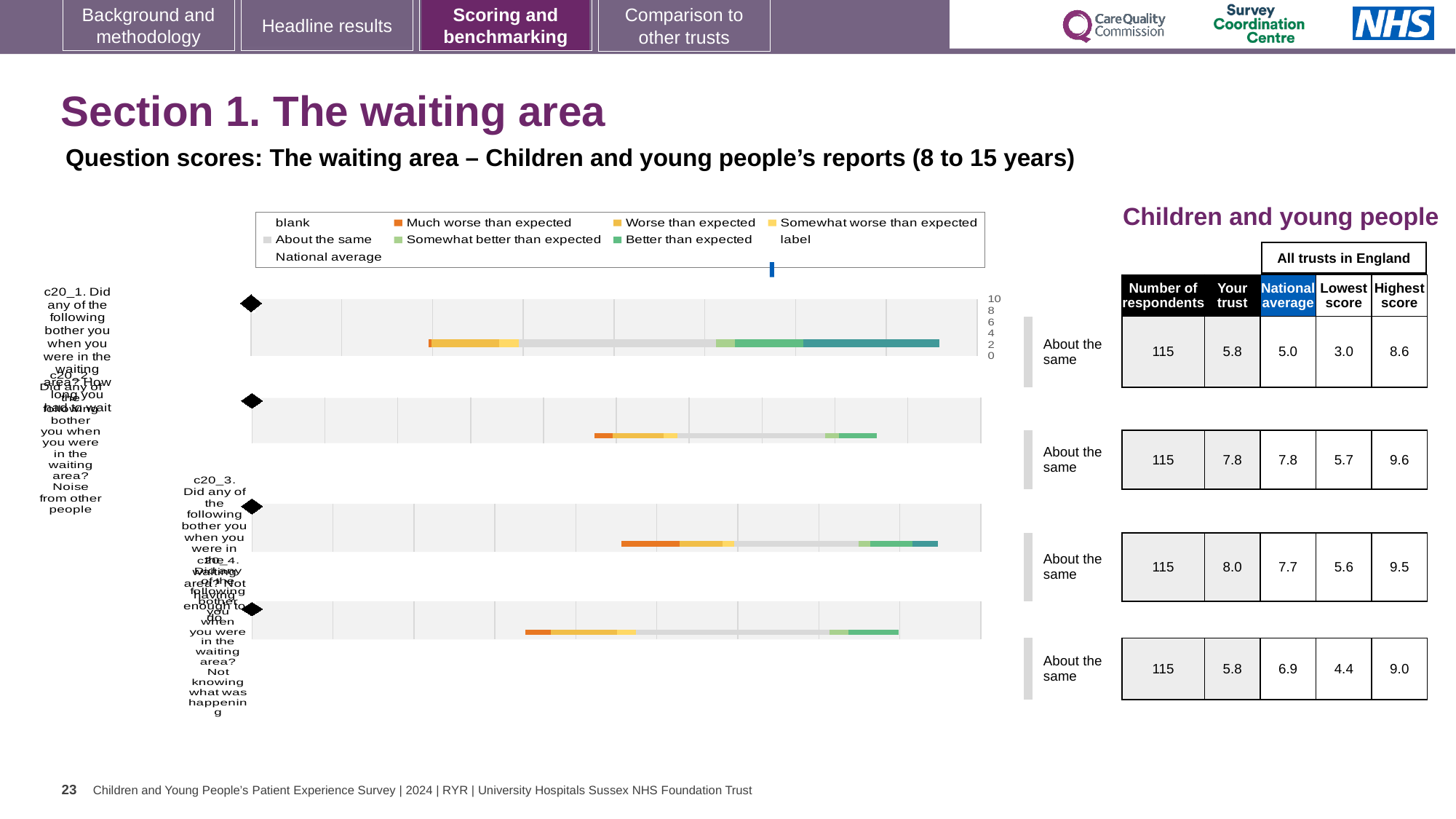
What benchmark category is shown next to each of the four question bars? About the same What kind of chart is used to show the question scores on this slide? bar chart What is the 'Highest score' for the third question row (c20_3)? 9.5 What is the national average for the fourth question row (c20_4)? 6.9 How many question bars (c20_1 to c20_4) are plotted on the slide? 4 Which question row has the highest 'Your trust' score? the third row (c20_3), 8.0 For the third question row (c20_3), what is the difference between the 'Your trust' score and the national average? 0.3 What is the 'Your trust' score for the second question row (c20_2)? 7.8 In the chart legend, what colour represents 'Much worse than expected'? orange Which question row has the lowest 'Lowest score' value? the first row (c20_1), 3.0 For the fourth question row (c20_4), which is larger: the 'Your trust' score or the national average? national average What is the number of respondents shown for the first question row (c20_1)? 115